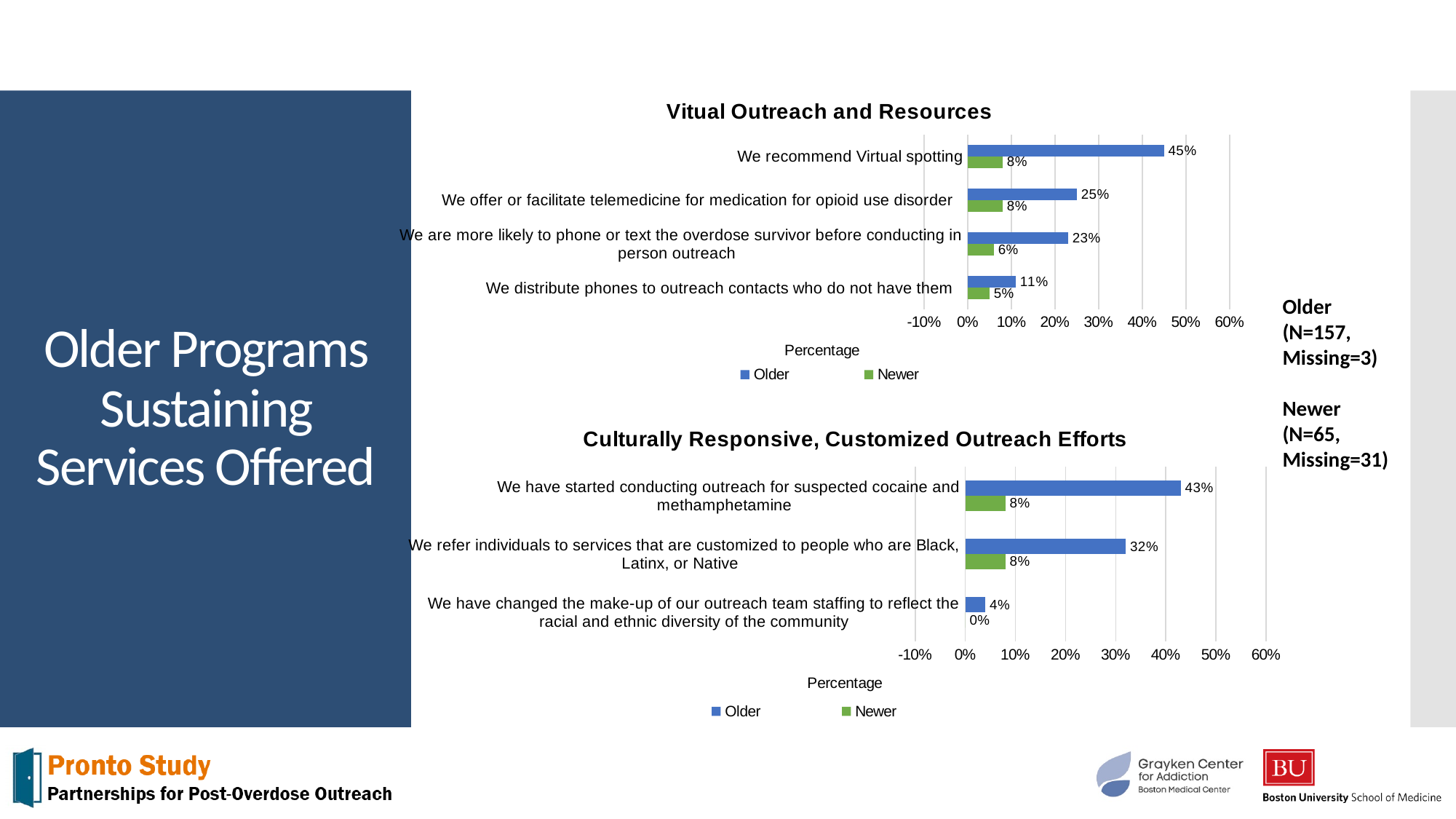
In the 'Vitual Outreach and Resources' chart, what is the Newer value for 'We distribute phones to outreach contacts who do not have them'? 5% In the 'Culturally Responsive, Customized Outreach Efforts' chart, what is the Newer value for 'We have changed the make-up of our outreach team staffing to reflect the racial and ethnic diversity of the community'? 0% In the 'Vitual Outreach and Resources' chart, which category has the highest Older value? We recommend Virtual spotting In the 'Culturally Responsive, Customized Outreach Efforts' chart, what is the difference between the Older and Newer values for 'We have started conducting outreach for suspected cocaine and methamphetamine'? 35% In the 'Culturally Responsive, Customized Outreach Efforts' chart, what is the Older value for 'We refer individuals to services that are customized to people who are Black, Latinx, or Native'? 32% In the 'Vitual Outreach and Resources' chart, which category has the lowest Older value? We distribute phones to outreach contacts who do not have them In the 'Vitual Outreach and Resources' chart, what is the Older value for 'We recommend Virtual spotting'? 45% What type of chart is the 'Culturally Responsive, Customized Outreach Efforts' chart? Bar chart In the 'Vitual Outreach and Resources' chart, what is the difference between the Older and Newer values for 'We recommend Virtual spotting'? 37% In the 'Culturally Responsive, Customized Outreach Efforts' chart, how many series does the legend list? 2 In the 'Vitual Outreach and Resources' chart, how many categories are shown? 4 In the 'Culturally Responsive, Customized Outreach Efforts' chart, which category has the highest Older value? We have started conducting outreach for suspected cocaine and methamphetamine